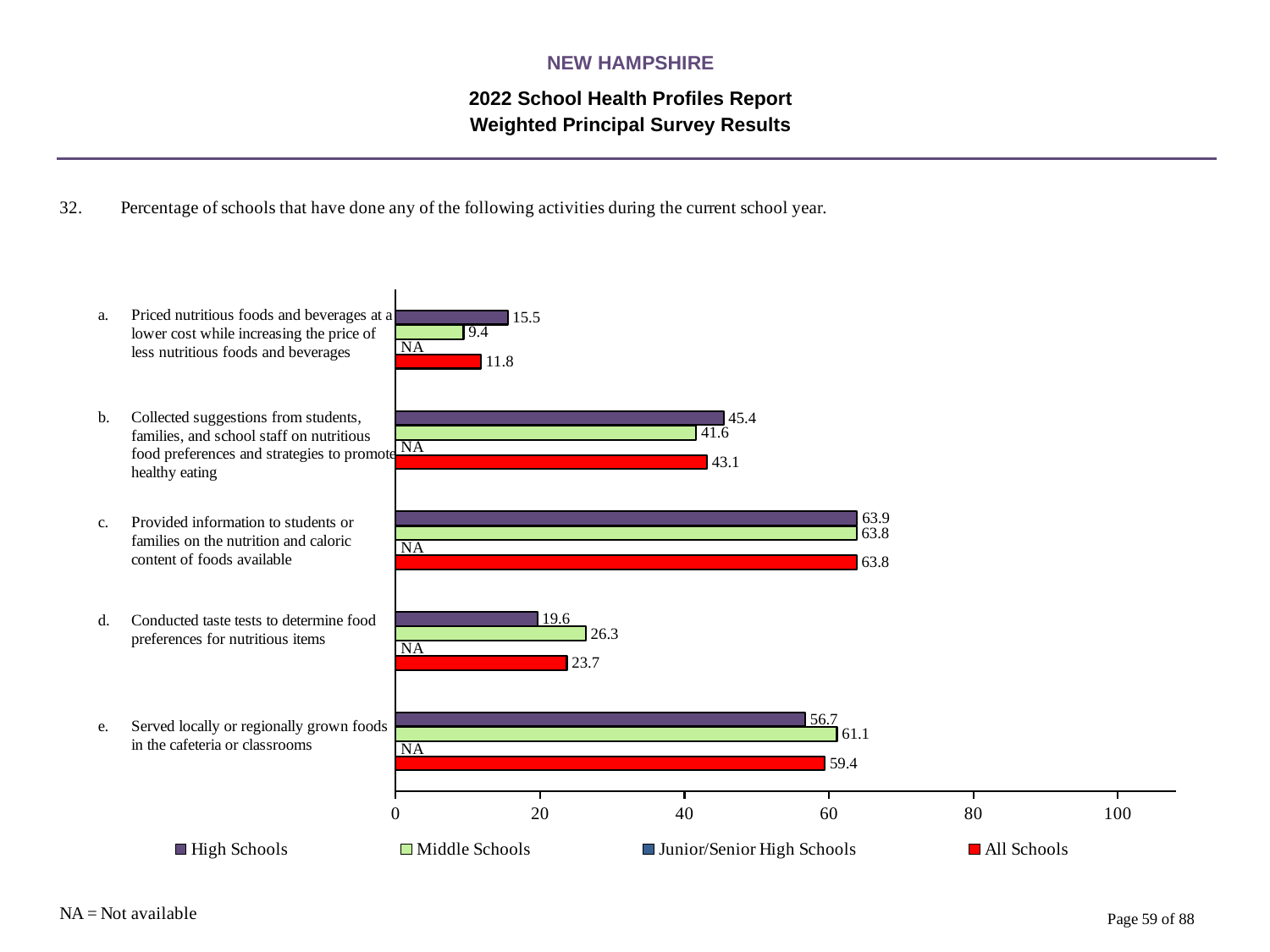
What is the High Schools value for 'Collected suggestions from students, families, and school staff on nutritious food preferences and strategies to promote healthy eating'? 45.4 What is shown for Junior/Senior High Schools for 'Provided information to students or families on the nutrition and caloric content of foods available'? NA What is the difference between the Middle Schools and High Schools values for 'Conducted taste tests to determine food preferences for nutritious items'? 6.7 What is the All Schools value for 'Served locally or regionally grown foods in the cafeteria or classrooms'? 59.4 For 'Served locally or regionally grown foods in the cafeteria or classrooms', which is larger: the High Schools value or the Middle Schools value? Middle Schools Which activity has the highest High Schools value? Provided information to students or families on the nutrition and caloric content of foods available How many series does the legend list? 4 What kind of chart is shown on the slide? Bar chart What is the Middle Schools value for 'Conducted taste tests to determine food preferences for nutritious items'? 26.3 Which activity has the lowest Middle Schools value? Priced nutritious foods and beverages at a lower cost while increasing the price of less nutritious foods and beverages Is the All Schools value for 'Collected suggestions from students, families, and school staff on nutritious food preferences and strategies to promote healthy eating' greater or less than 40? greater How many activities (categories) are listed on the chart? 5